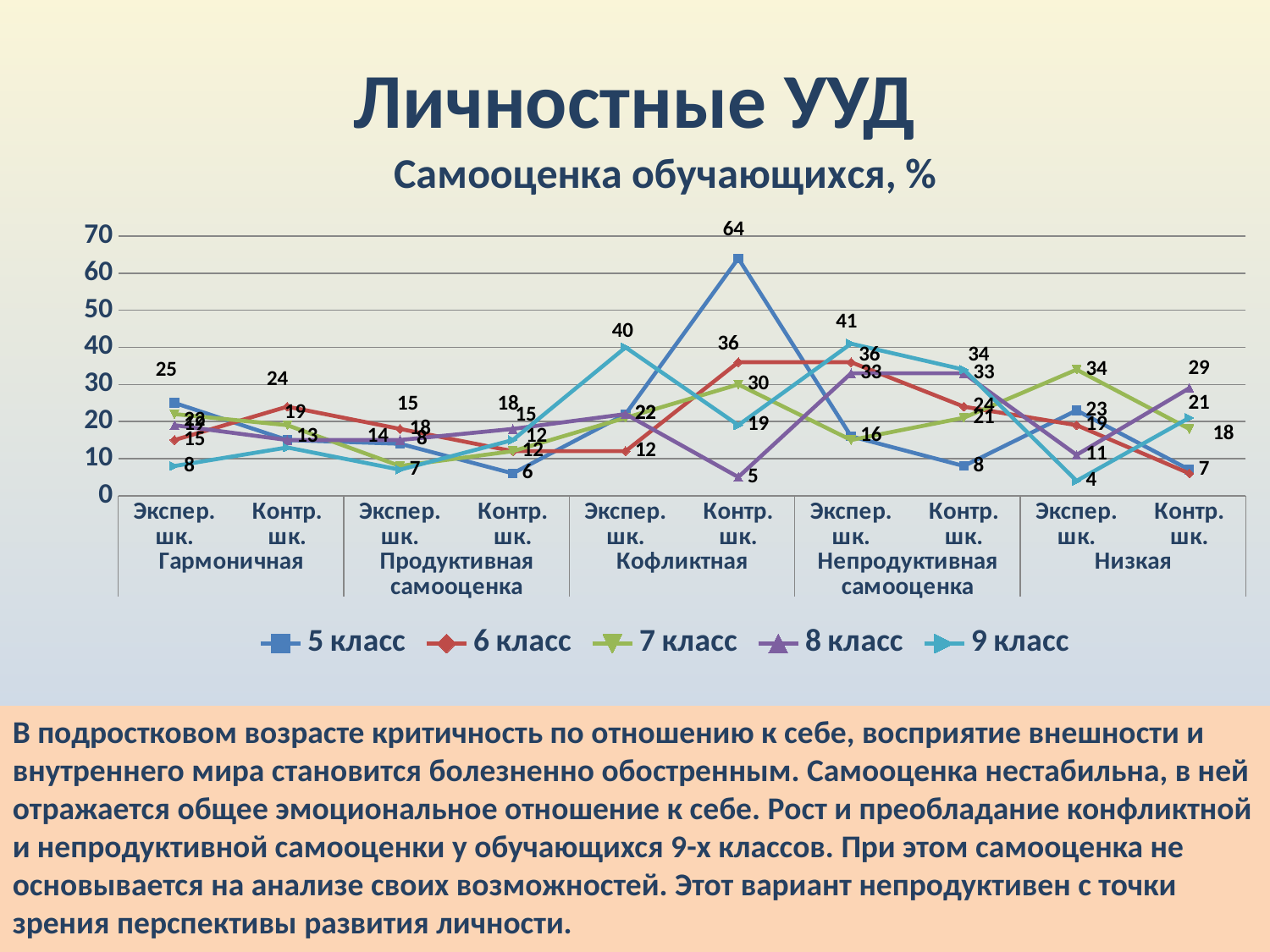
What is the value for 8 класс at Контр. шк. in the Низкая group? 29 Which series has the lowest value at Контр. шк. in the Кофликтная group? 8 класс What type of chart is shown on the slide? line chart What is the difference between the 5 класс value (64) and the 6 класс value (36) at Контр. шк. in the Кофликтная group? 28 Which series has the highest value at Контр. шк. in the Кофликтная group? 5 класс What is the value for 5 класс at Контр. шк. in the Кофликтная group? 64 Which is larger at Экспер. шк. in the Низкая group: the value for 7 класс or the value for 9 класс? 7 класс What is the value for 7 класс at Экспер. шк. in the Низкая group? 34 What is the value for 5 класс at Экспер. шк. in the Гармоничная group? 25 What is the value for 9 класс at Экспер. шк. in the Непродуктивная самооценка group? 41 How many series does the legend list? 5 What is the value for 9 класс at Экспер. шк. in the Кофликтная group? 40